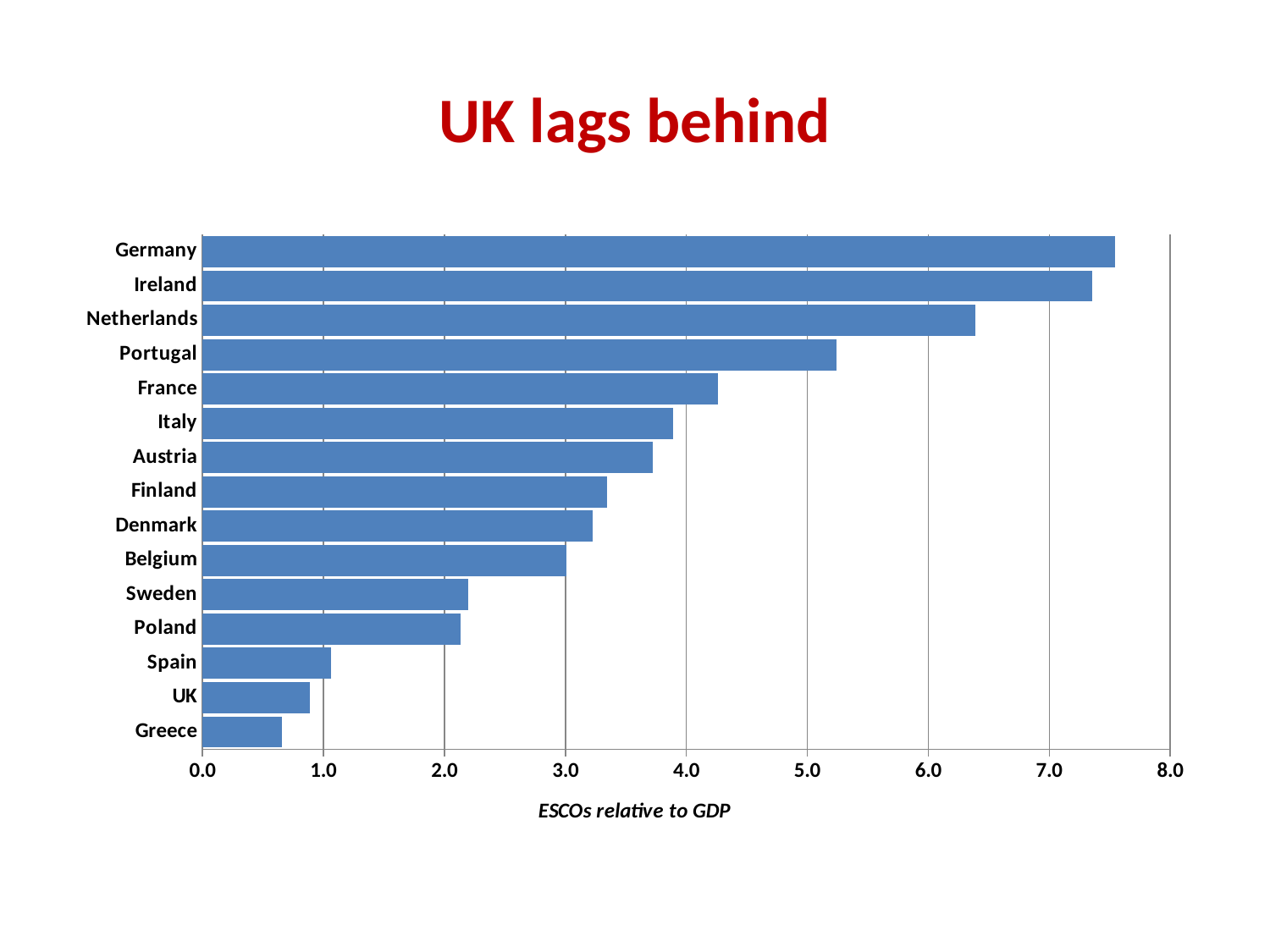
Which has a larger value, UK or Spain? Spain Which has a larger value, France or Sweden? France How many countries are shown in the chart? 15 Which country has the lowest value for ESCOs relative to GDP? Greece Is the value for Portugal greater or less than 5.0? greater What is the label on the horizontal axis of the chart? ESCOs relative to GDP Which country has the highest value for ESCOs relative to GDP? Germany Is the value for Netherlands greater or less than 6.0? greater Is the value for UK greater or less than 1.0? less What kind of chart is shown on the slide? bar chart